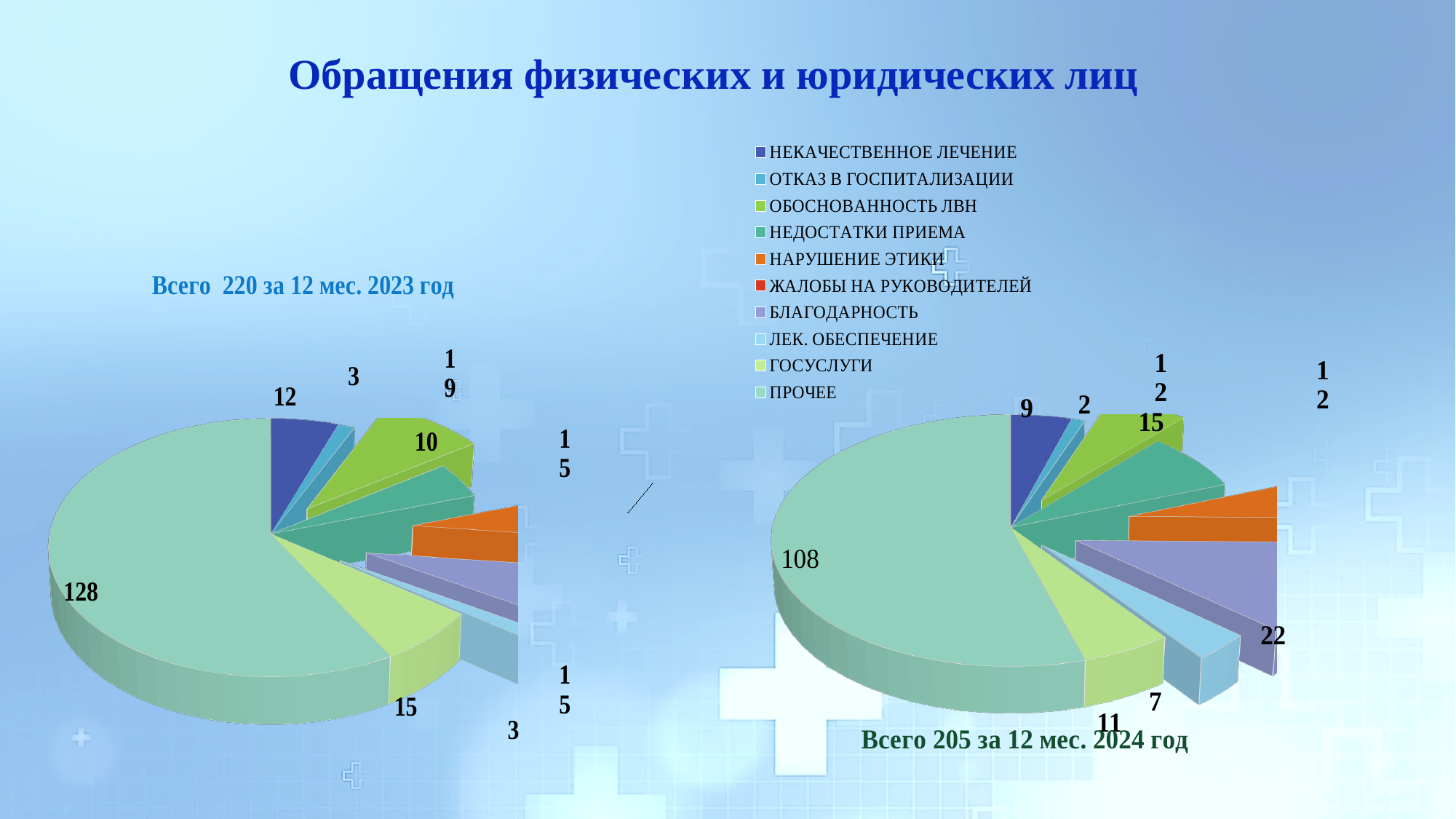
How many categories does the legend list? 10 In the right chart (2024), what is the value of the largest slice (ПРОЧЕЕ)? 108 In the left chart (2023), what is the value of the largest slice (ПРОЧЕЕ)? 128 In the left chart (2023), what total number of appeals is stated in the chart title? 220 In the left chart (2023), what is the value for НЕКАЧЕСТВЕННОЕ ЛЕЧЕНИЕ? 12 In the right chart (2024), what is the value for НЕКАЧЕСТВЕННОЕ ЛЕЧЕНИЕ? 9 What kind of charts are shown on the slide? Pie charts In the right chart (2024), what is the value for ГОСУСЛУГИ? 11 In the right chart (2024), what is the value for БЛАГОДАРНОСТЬ? 22 What is the difference between the stated totals of the 2023 chart and the 2024 chart? 15 In the right chart (2024), what total number of appeals is stated in the chart title? 205 Which year has the larger value for ПРОЧЕЕ, 2023 (left chart) or 2024 (right chart)? 2023